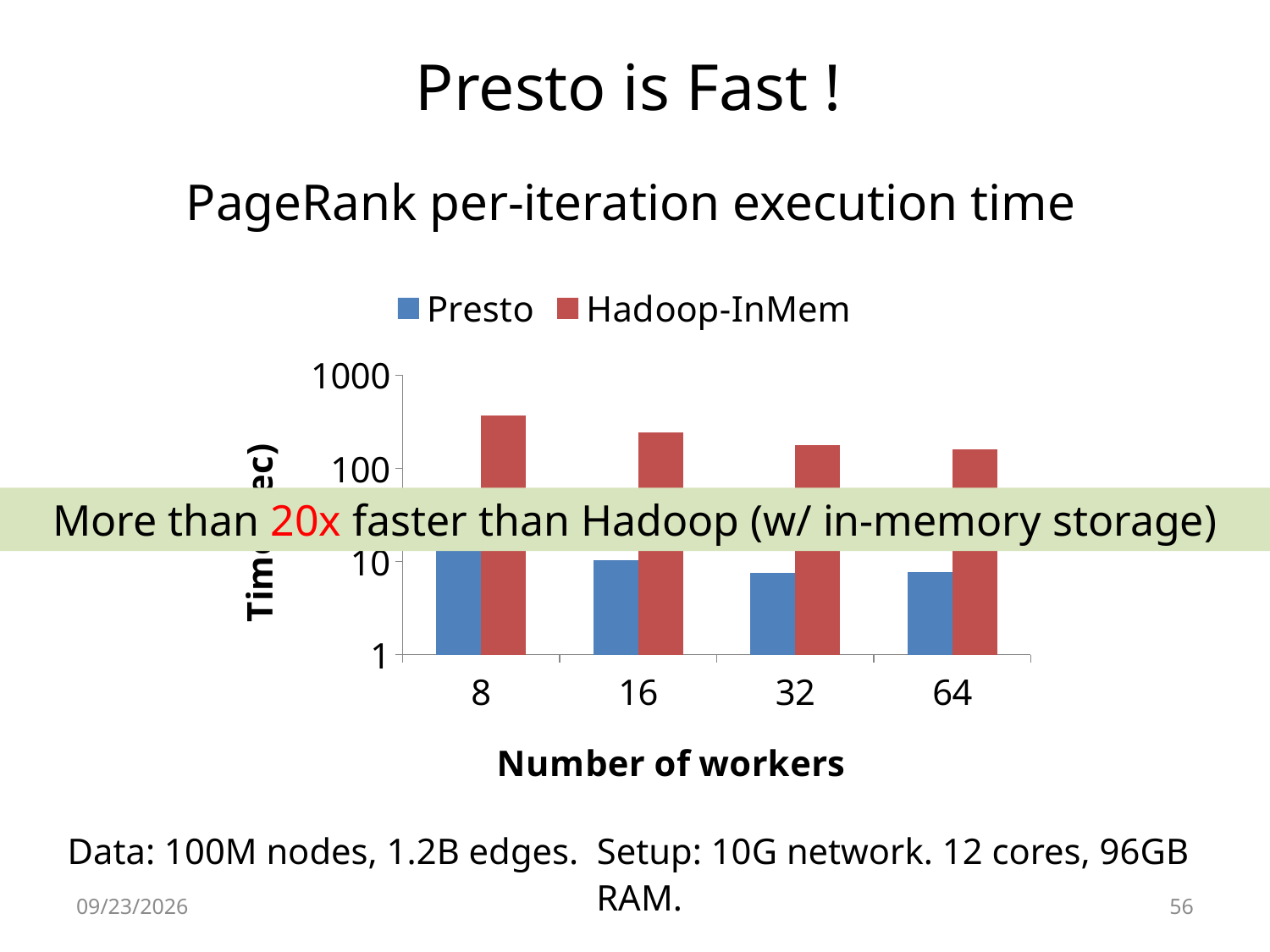
How many worker counts are shown on the x axis of the chart? 4 What kind of chart is shown on the slide? bar chart At 16 workers, which series has the larger execution time, Presto or Hadoop-InMem? Hadoop-InMem How many series does the chart legend list? 2 At which number of workers is the Hadoop-InMem execution time highest? 8 Does the Hadoop-InMem execution time rise or fall as the number of workers increases from 8 to 64? fall What is the label of the x axis of the chart? Number of workers Is the Presto value for 32 workers greater or less than 10? less Is the Hadoop-InMem value for 8 workers greater or less than 100? greater Is the Presto value for 8 workers greater or less than 10? greater Which series are listed in the chart legend? Presto and Hadoop-InMem